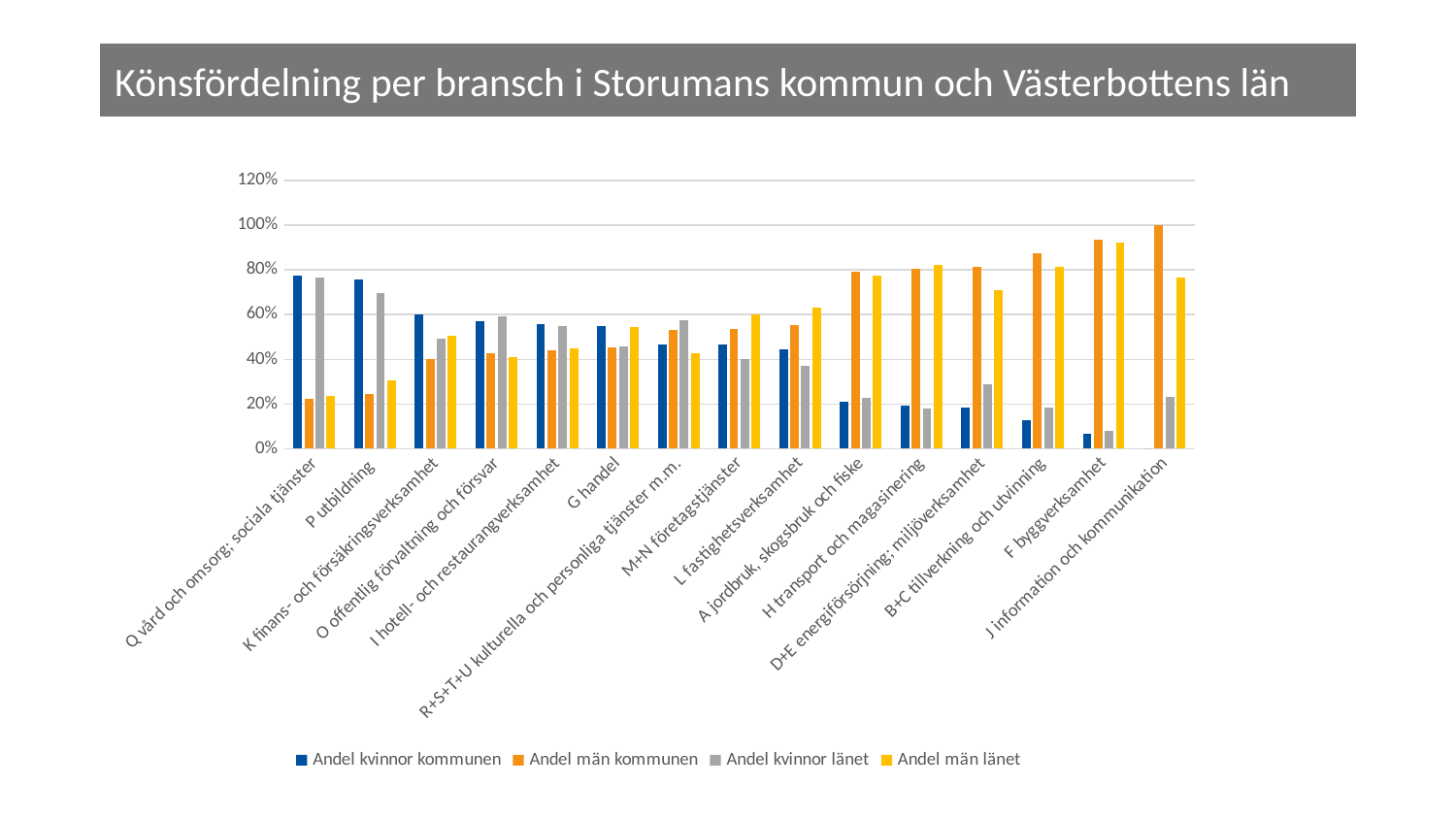
What kind of chart is shown on the slide? Bar chart How many series does the legend list? 4 For F byggverksamhet, which is larger: Andel män kommunen or Andel kvinnor kommunen? Andel män kommunen Is the value of Andel män kommunen for F byggverksamhet greater or less than 80%? greater For Q vård och omsorg; sociala tjänster, which is larger: Andel kvinnor kommunen or Andel män kommunen? Andel kvinnor kommunen Is the value of Andel kvinnor länet for A jordbruk, skogsbruk och fiske greater or less than 40%? less Which category has the highest value for Andel män kommunen? J information och kommunikation How many industry categories are shown on the x axis? 15 Which colour represents Andel män länet in the legend? Yellow Do the values for Andel män kommunen generally rise or fall from left to right along the x axis? Rise What is the title of the chart? Könsfördelning per bransch i Storumans kommun och Västerbottens län Is the value of Andel kvinnor kommunen for Q vård och omsorg; sociala tjänster greater or less than 60%? greater